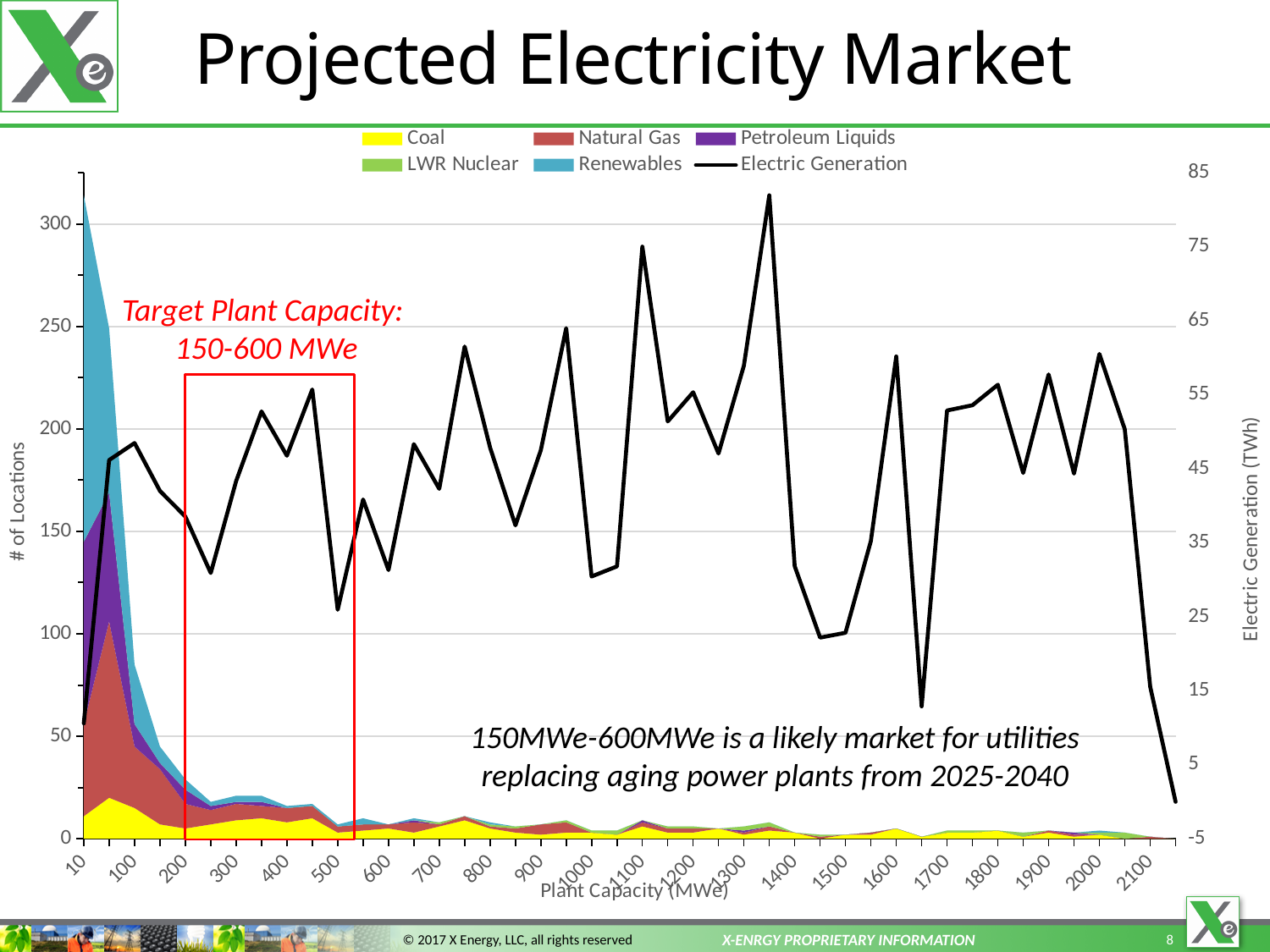
Is the peak value of the Electric Generation line greater or less than 75 TWh? greater Is the total number of locations at 100 MWe greater or less than 100? less Is the total number of locations at 10 MWe greater or less than 250? greater Which is larger, the Electric Generation value near 1350 MWe or near 1500 MWe? near 1350 MWe What is the title of the chart? Projected Electricity Market How many series does the legend list? 6 What target plant capacity range is highlighted on the chart? 150-600 MWe Which series is plotted as a black line? Electric Generation Does the total number of locations rise or fall as plant capacity increases? fall What kind of chart is this? A combination chart: stacked area chart with a line Which series accounts for the most locations at 10 MWe? Renewables